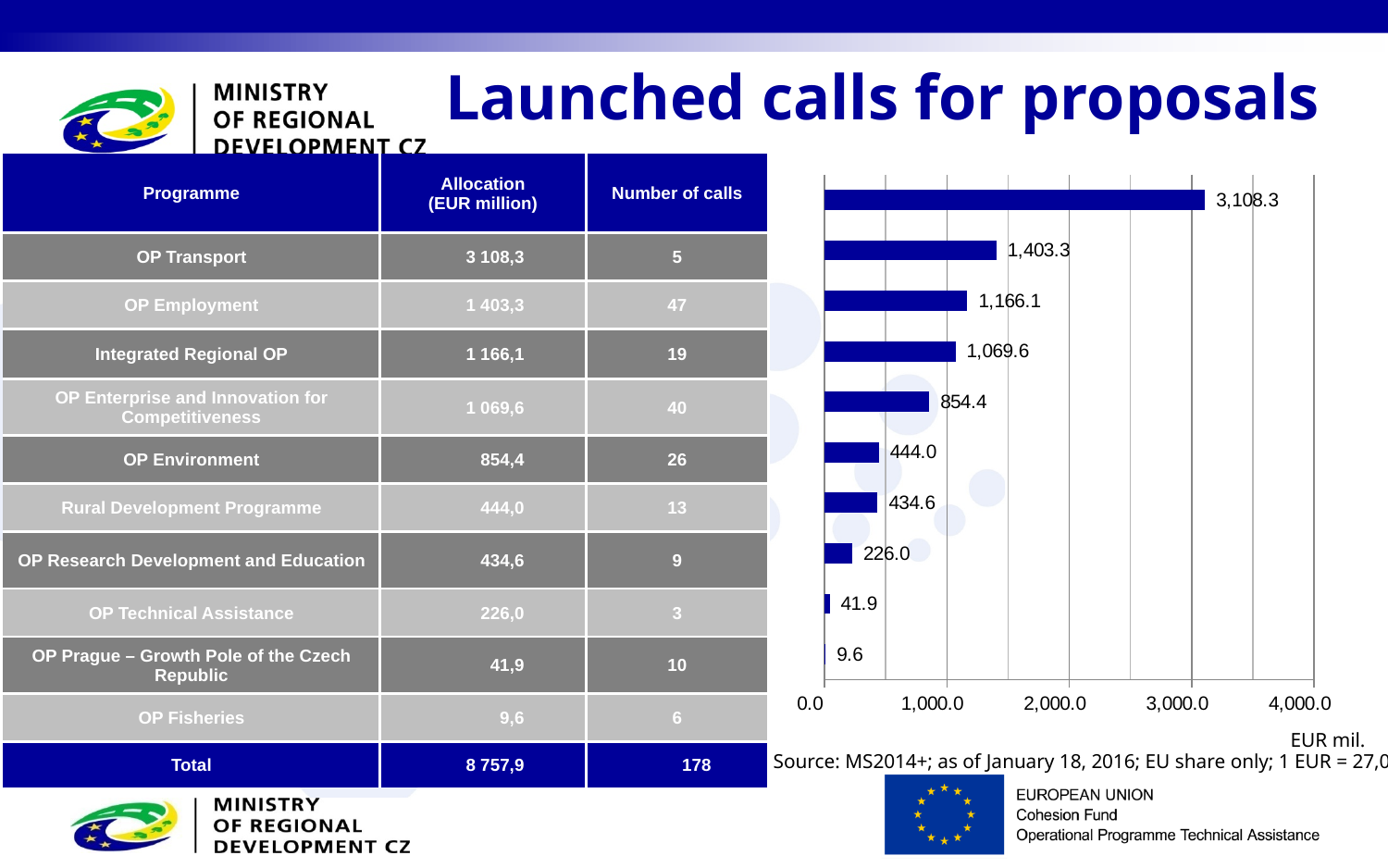
Which is larger in the chart: the bar labelled 444.0 or the bar labelled 434.6? 444.0 What value is labelled on the second bar from the top of the chart? 1,403.3 Is the value of the top bar in the chart greater or less than 3,000.0? greater What is the difference between the top bar (3,108.3) and the second bar (1,403.3) in the chart? 1,705.0 What is the value labelled on the shortest (bottom) bar of the chart? 9.6 What kind of chart is shown on the right side of the slide? Bar chart What is the highest tick value shown on the x axis of the chart? 4,000.0 Do the bar values rise or fall going from the top of the chart to the bottom? Fall What value is labelled on the fifth bar from the top of the chart? 854.4 How many bars does the chart on the right contain? 10 What unit is indicated below the x axis of the chart? EUR mil. What is the value labelled on the longest (top) bar of the chart? 3,108.3